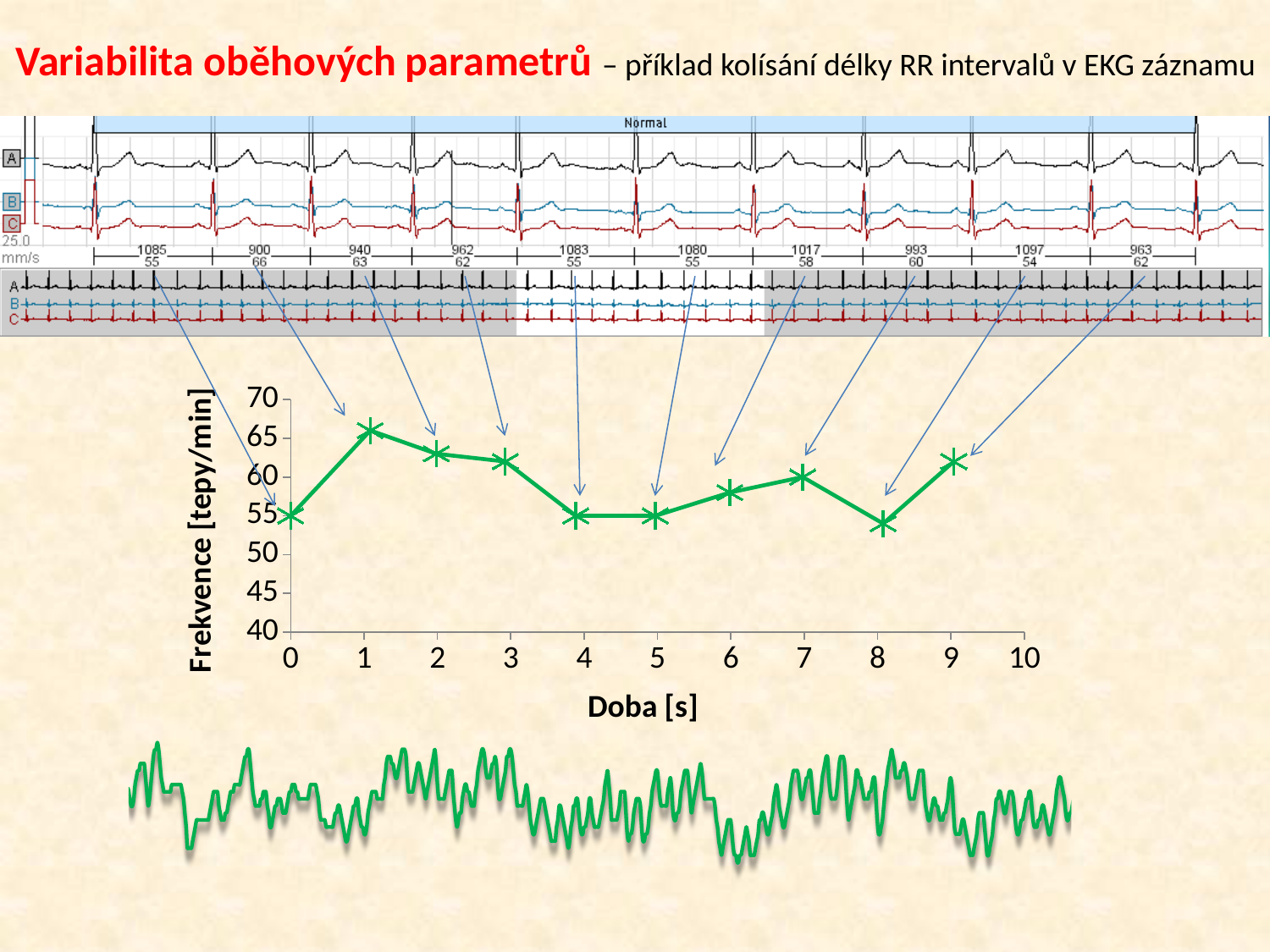
At which time (in seconds) does the line chart reach its highest frequency? 1 What kind of chart is shown in the middle of the slide? line chart What is the label of the vertical axis of the line chart? Frekvence [tepy/min] Which point has the higher frequency on the line chart: the one at 1 s or the one at 2 s? 1 s Is the frequency value at 1 s greater or less than 60? greater What is the label of the horizontal axis of the line chart? Doba [s] Is the frequency value at 4 s greater or less than 60? less Does the frequency on the line chart rise or fall between 1 s and 4 s? fall How many data points are plotted on the line chart? 10 Is the frequency value at 9 s greater or less than 60? greater What is the frequency value of the point at 7 s on the line chart? 60 What is the frequency value of the first point, at 0 s, on the line chart? 55